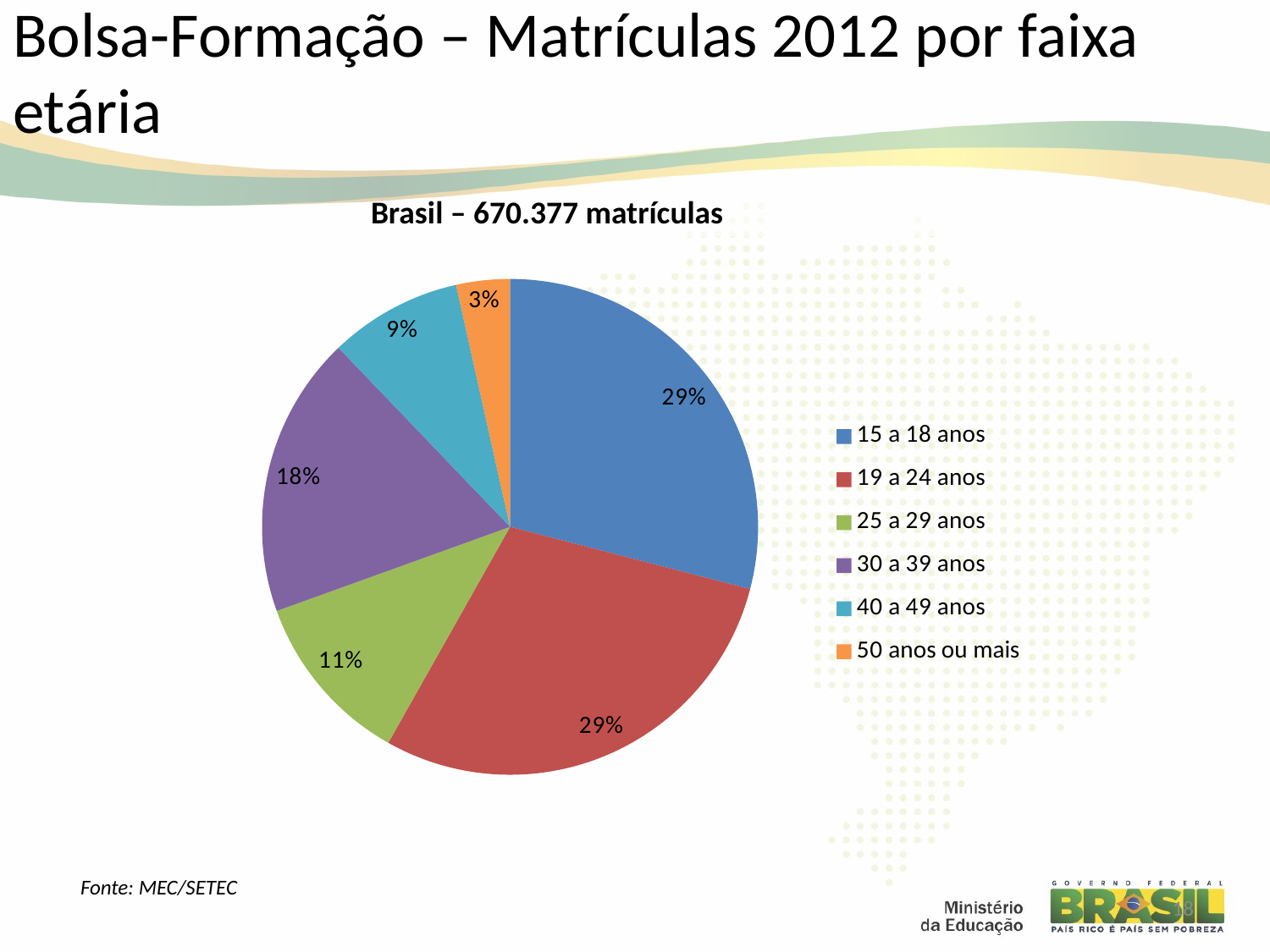
What colour is the 19 a 24 anos slice? Red What share of the pie does the 50 anos ou mais slice represent? 3% Which slice is larger, 25 a 29 anos or 30 a 39 anos? 30 a 39 anos Which age group has the smallest slice of the pie? 50 anos ou mais What share of the pie does the 40 a 49 anos slice represent? 9% How many age groups does the legend list? 6 What kind of chart is shown on the slide? Pie chart What share of the pie does the 30 a 39 anos slice represent? 18% What is the title of the chart? Brasil – 670.377 matrículas What is the difference in percentage points between the 30 a 39 anos slice and the 40 a 49 anos slice? 9 What is the combined share of the 15 a 18 anos and 19 a 24 anos slices? 58%